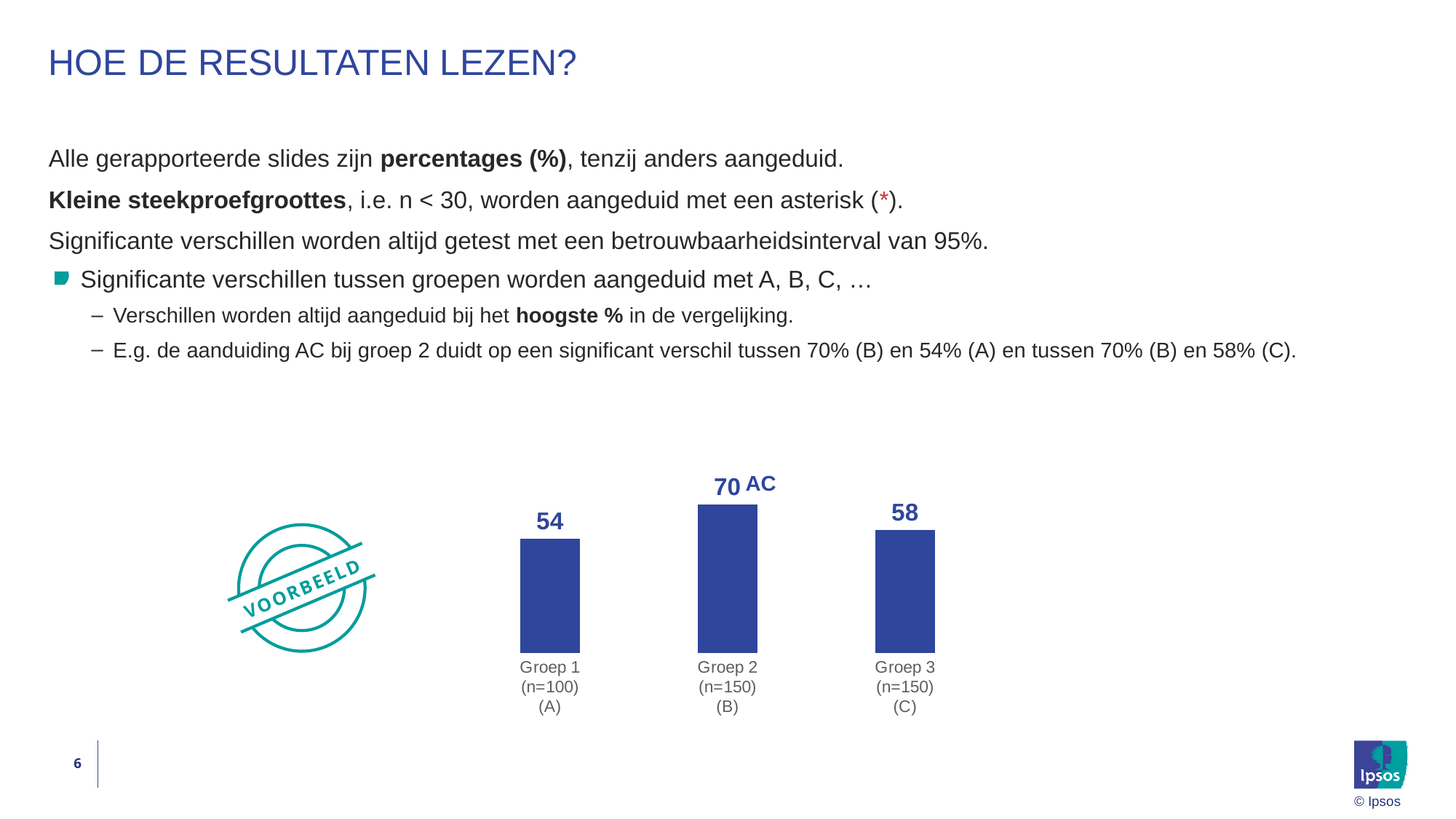
What is the difference between the values for Groep 2 and Groep 1? 16 What kind of chart is shown on the slide? Bar chart What is the value shown for Groep 3 (n=150) (C)? 58 What is the sample size (n) shown for Groep 1? n=100 What is the difference between the values for Groep 3 and Groep 1? 4 Which group has the lowest value in the chart? Groep 1 Which significance letters are printed next to the value for Groep 2? AC Which group has the highest value in the chart? Groep 2 What is the value shown for Groep 1 (n=100) (A)? 54 How many groups (bars) are shown in the chart? 3 Which has a larger value, Groep 2 or Groep 3? Groep 2 What is the value shown for Groep 2 (n=150) (B)? 70